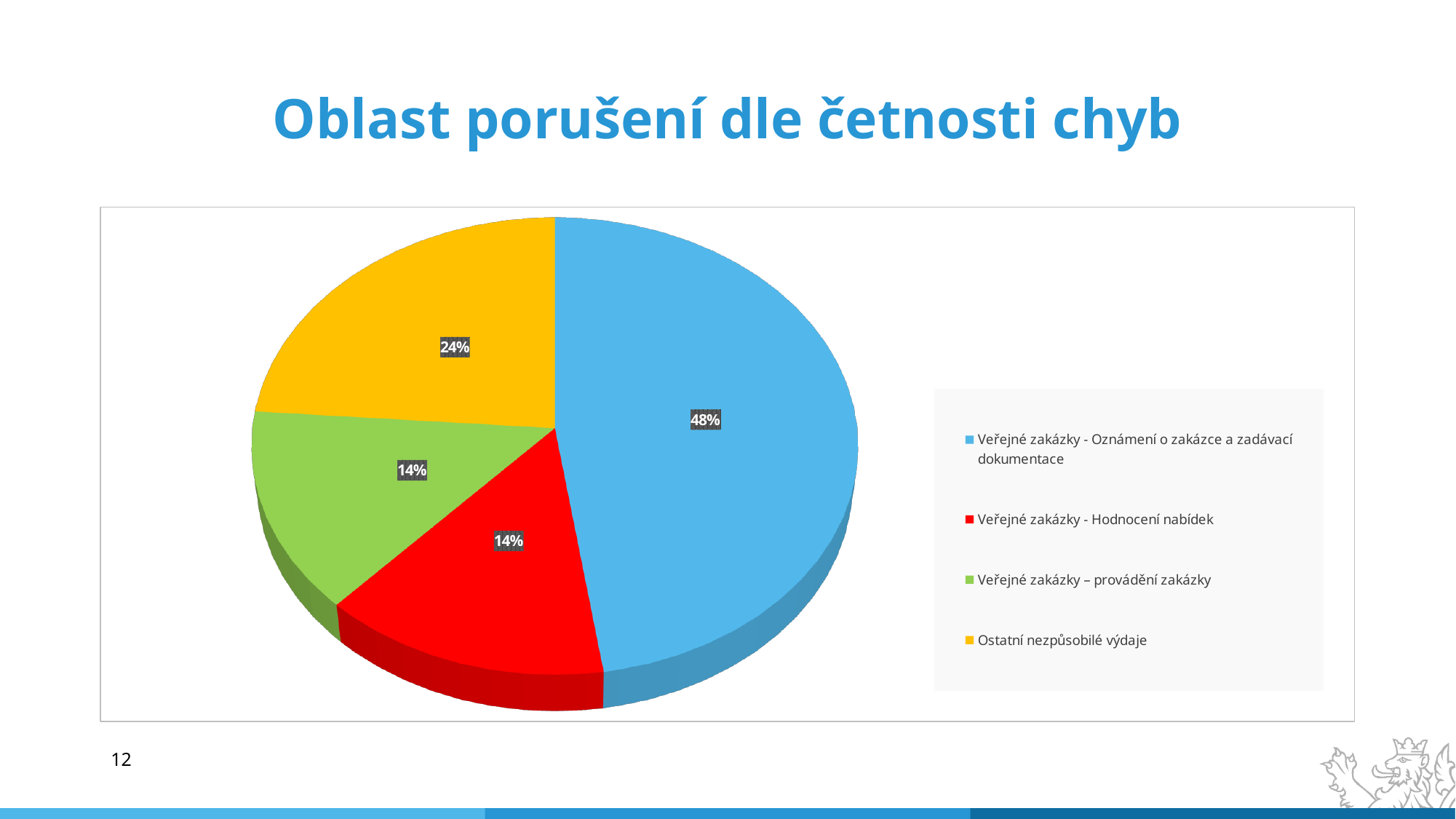
What share of the pie does 'Ostatní nezpůsobilé výdaje' have? 24% What share of the pie does 'Veřejné zakázky - Oznámení o zakázce a zadávací dokumentace' have? 48% What is the combined share of the two 14% slices? 28% What share of the pie does 'Veřejné zakázky – provádění zakázky' have? 14% How many categories does the pie chart show? 4 Which category has the largest slice of the pie? Veřejné zakázky - Oznámení o zakázce a zadávací dokumentace Which colour represents 'Veřejné zakázky - Hodnocení nabídek' in the pie chart? Red What is the title of the slide? Oblast porušení dle četnosti chyb Which slice is larger: 'Ostatní nezpůsobilé výdaje' or 'Veřejné zakázky - Hodnocení nabídek'? Ostatní nezpůsobilé výdaje What is the difference in percentage points between the 'Veřejné zakázky - Oznámení o zakázce a zadávací dokumentace' slice and the 'Ostatní nezpůsobilé výdaje' slice? 24 percentage points What kind of chart is shown on the slide? Pie chart